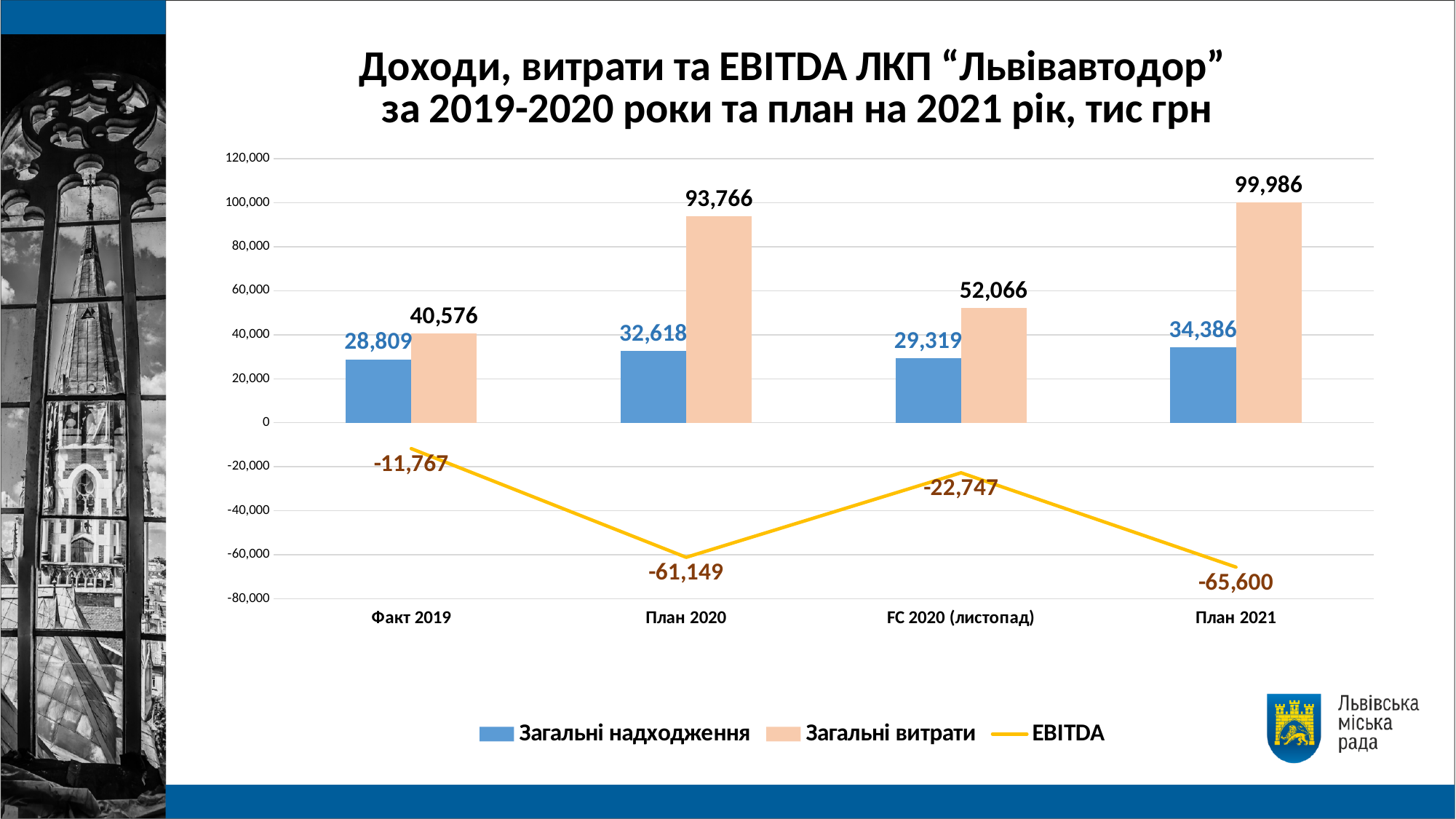
What is the difference between Загальні витрати and Загальні надходження for План 2020? 61,148 What is the value of Загальні витрати for FC 2020 (листопад)? 52,066 What is the value of Загальні витрати for План 2021? 99,986 What is the value of Загальні надходження for Факт 2019? 28,809 Which series is drawn as a line rather than bars? EBITDA How many categories are shown on the x axis? 4 Which is larger: Загальні надходження for План 2021 or for Факт 2019? План 2021 How many series does the legend list? 3 Is the value of Загальні витрати for План 2020 greater or less than 80,000? greater Which category has the lowest EBITDA value? План 2021 Which category has the highest value of Загальні витрати? План 2021 What is the EBITDA value for План 2020? -61,149